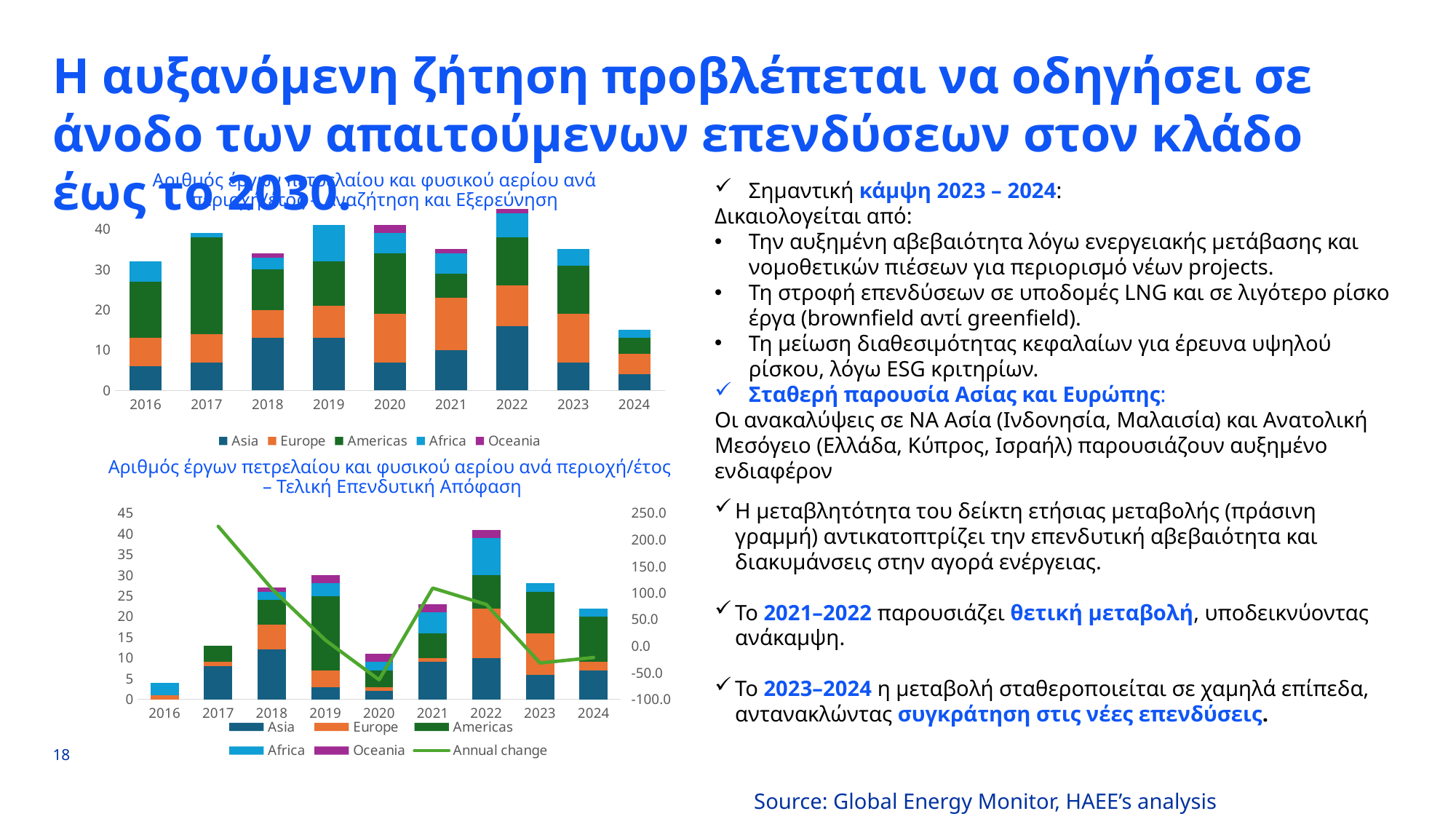
How many entries does the legend of the bottom chart list? 6 What kind of chart is the top chart on the slide? stacked bar chart In the bottom chart, in which year does the Annual change line reach its highest point? 2017 How many years are shown on the x axis of the top chart? 9 In the top chart, is the total for 2024 greater or less than 20? less In the top chart, which year has the tallest stacked bar? 2022 How many series does the legend of the top chart list? 5 In the bottom chart, which year has the tallest stacked bar? 2022 In the top chart, which year has the shortest stacked bar? 2024 In the top chart, which year has the larger total, 2017 or 2024? 2017 In the bottom chart, is the total for 2016 greater or less than 10? less